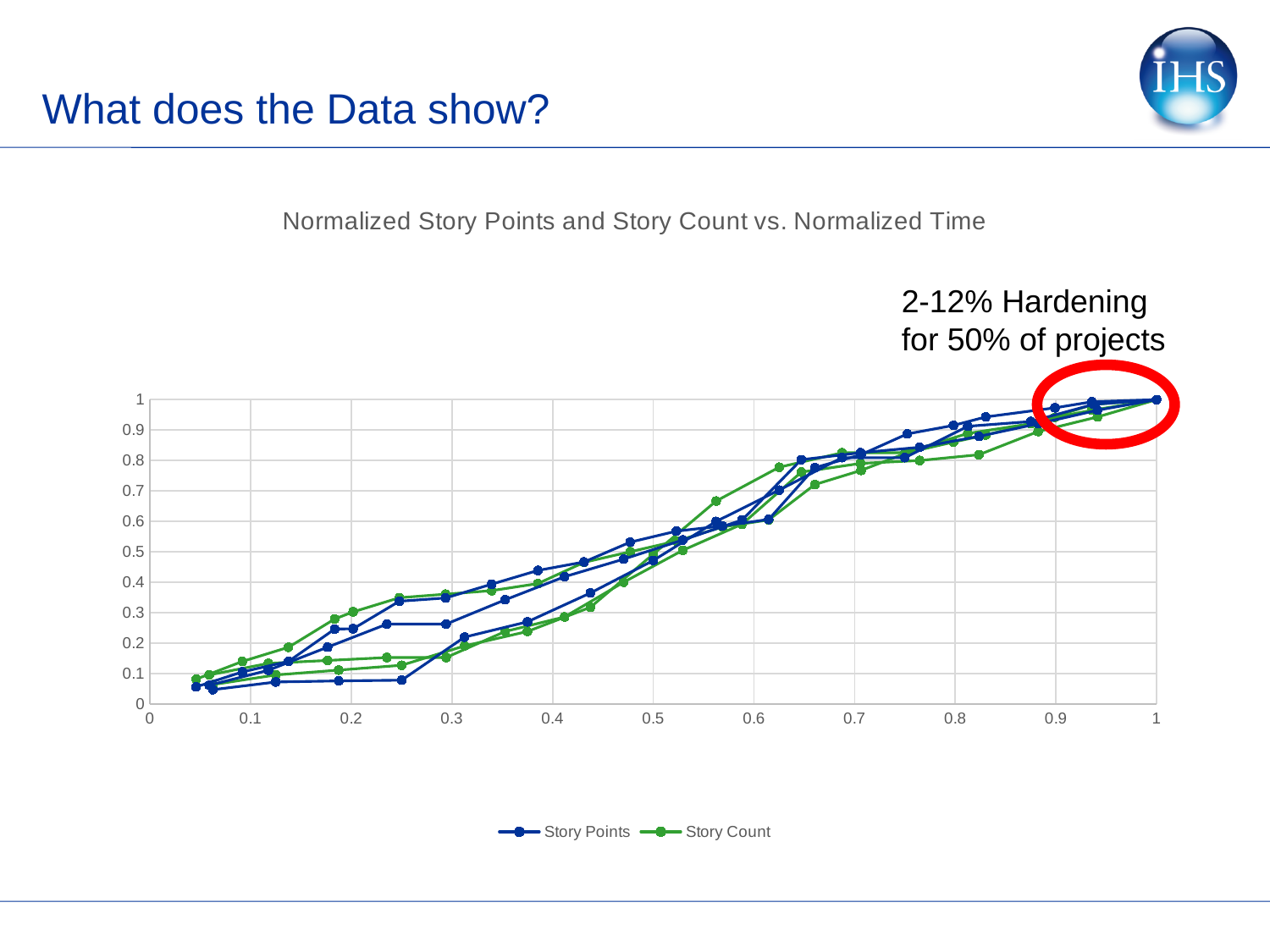
What is the lowest value shown on the x axis? 0 At x = 0.1, are the plotted values greater or less than 0.2? less What is the title of the chart? Normalized Story Points and Story Count vs. Normalized Time At x = 0.9, are the plotted values greater or less than 0.8? greater What kind of chart is shown on the slide? Line chart What value do all the lines reach at the right end of the x axis (x = 1)? 1 How many series does the legend list? 2 What annotation is written next to the red circle at the top right of the chart? 2-12% Hardening for 50% of projects Do the plotted values rise or fall as normalized time increases along the x axis? Rise What is the highest value shown on the y axis? 1 At x = 0.8, are the plotted values greater or less than 0.7? greater